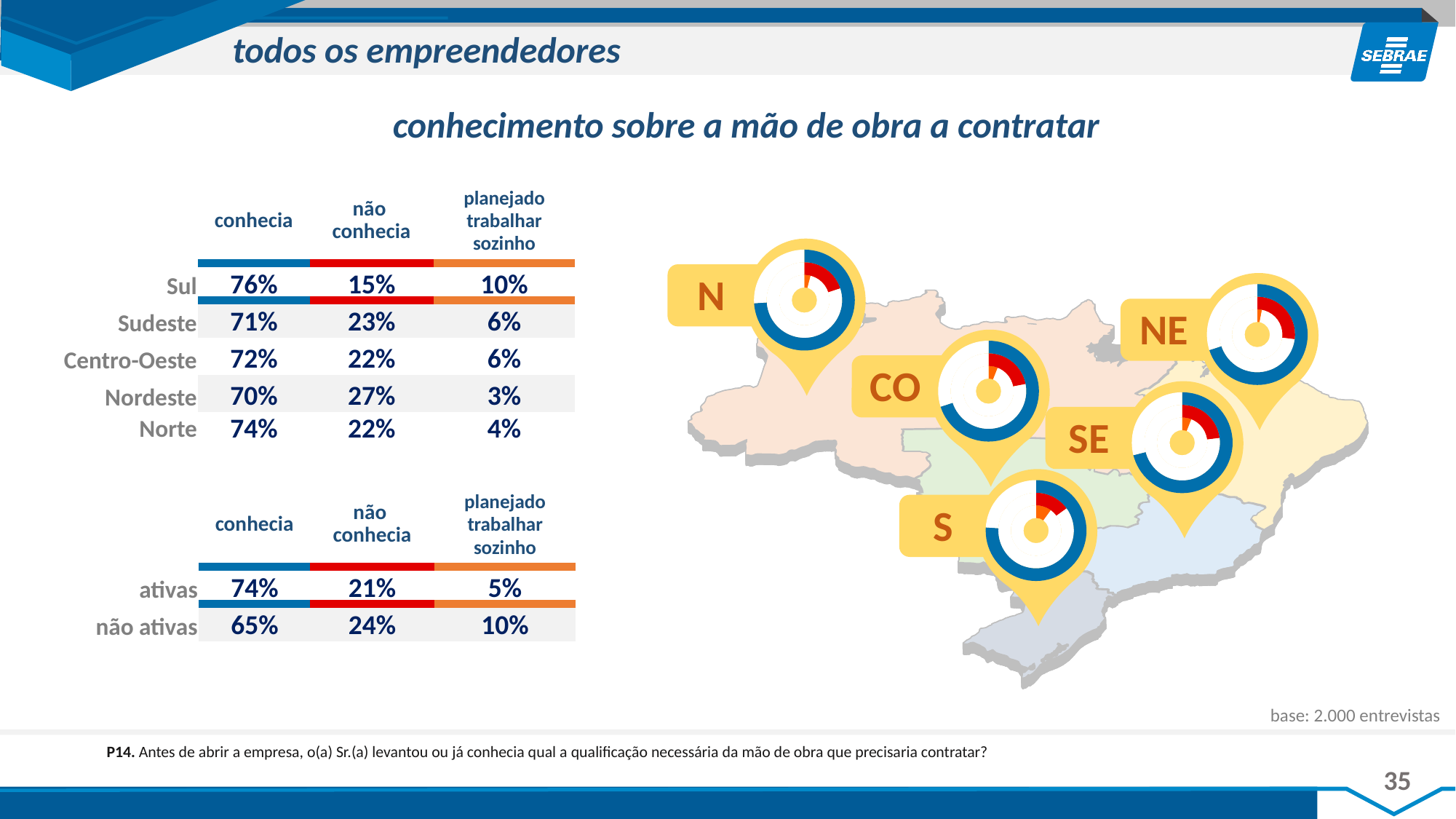
In the regional table, what is the 'não conhecia' value for Nordeste? 27% In the regional table, which region has the highest 'conhecia' percentage? Sul In the regional table, which region has the lowest 'planejado trabalhar sozinho' percentage? Nordeste In the regional table, which is larger: the 'conhecia' value for Sudeste or for Norte? Norte In the lower table, what is the 'conhecia' value for 'não ativas'? 65% In the regional table, what is the 'planejado trabalhar sozinho' value for Norte? 4% In the lower table, what is the difference between the 'conhecia' values for 'ativas' and 'não ativas'? 9 percentage points How many categories (columns) does each table show for the responses? 3 In the regional table, what percentage of entrepreneurs in Sul 'conhecia' the workforce to hire? 76% What kind of charts are placed on the map of Brazil? Donut (ring) charts How many regions are listed in the regional table? 5 In the regional table, what is the difference between the 'não conhecia' values for Nordeste and Sul? 12 percentage points